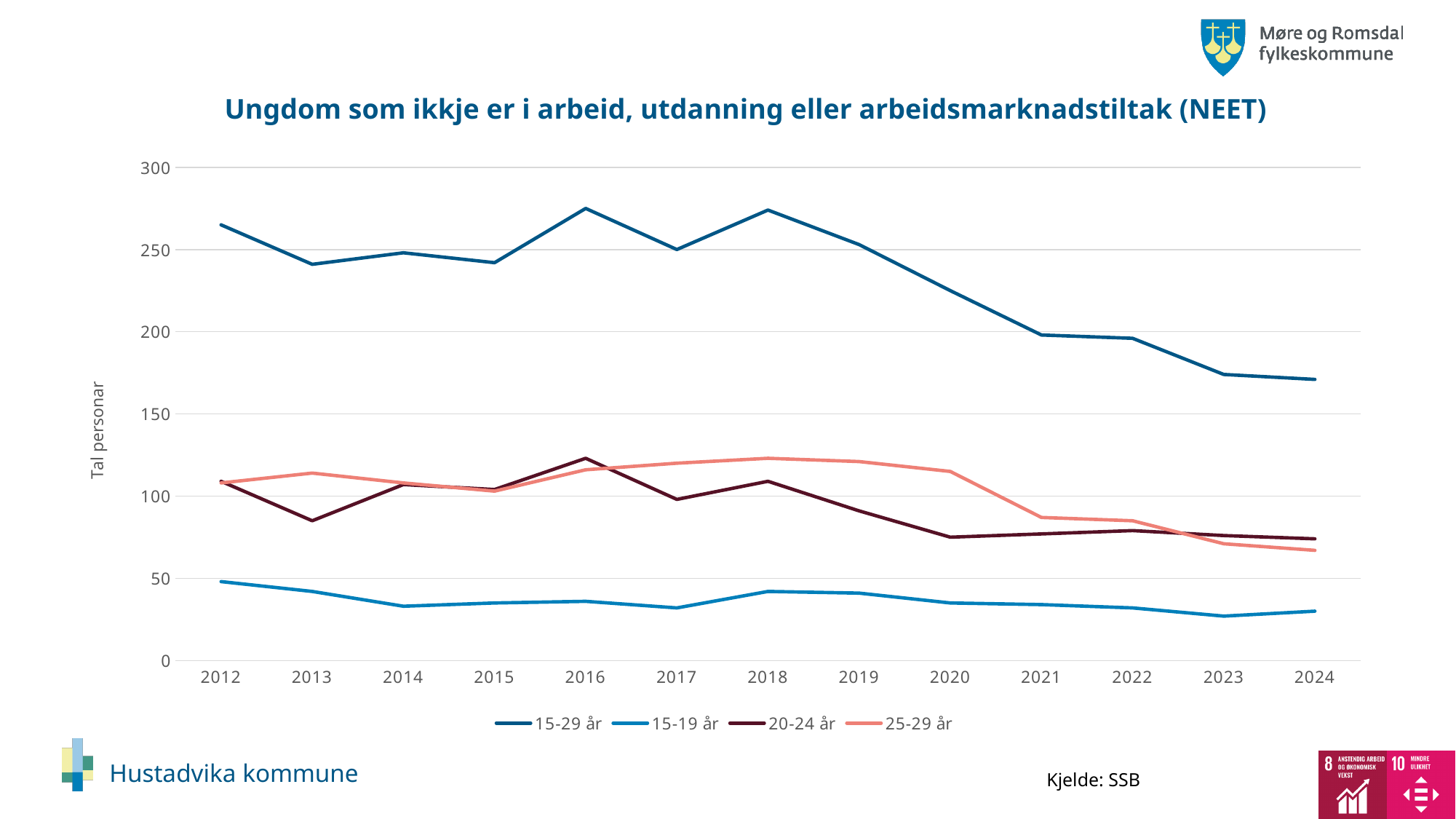
Is the value for 25-29 år in 2020 greater or less than 100? greater How many years are shown on the x axis? 13 What is the label on the y axis? Tal personar In 2013, which is larger: the value for 20-24 år or for 25-29 år? 25-29 år Is the value for 15-29 år in 2024 greater or less than 200? less What kind of chart is shown on the slide? line chart How many series does the legend list? 4 Does the value for 15-29 år rise or fall overall from 2012 to 2024? fall Is the value for 15-29 år in 2016 greater or less than 250? greater In which year is the value for 20-24 år highest? 2016 In which year is the value for 15-19 år highest? 2012